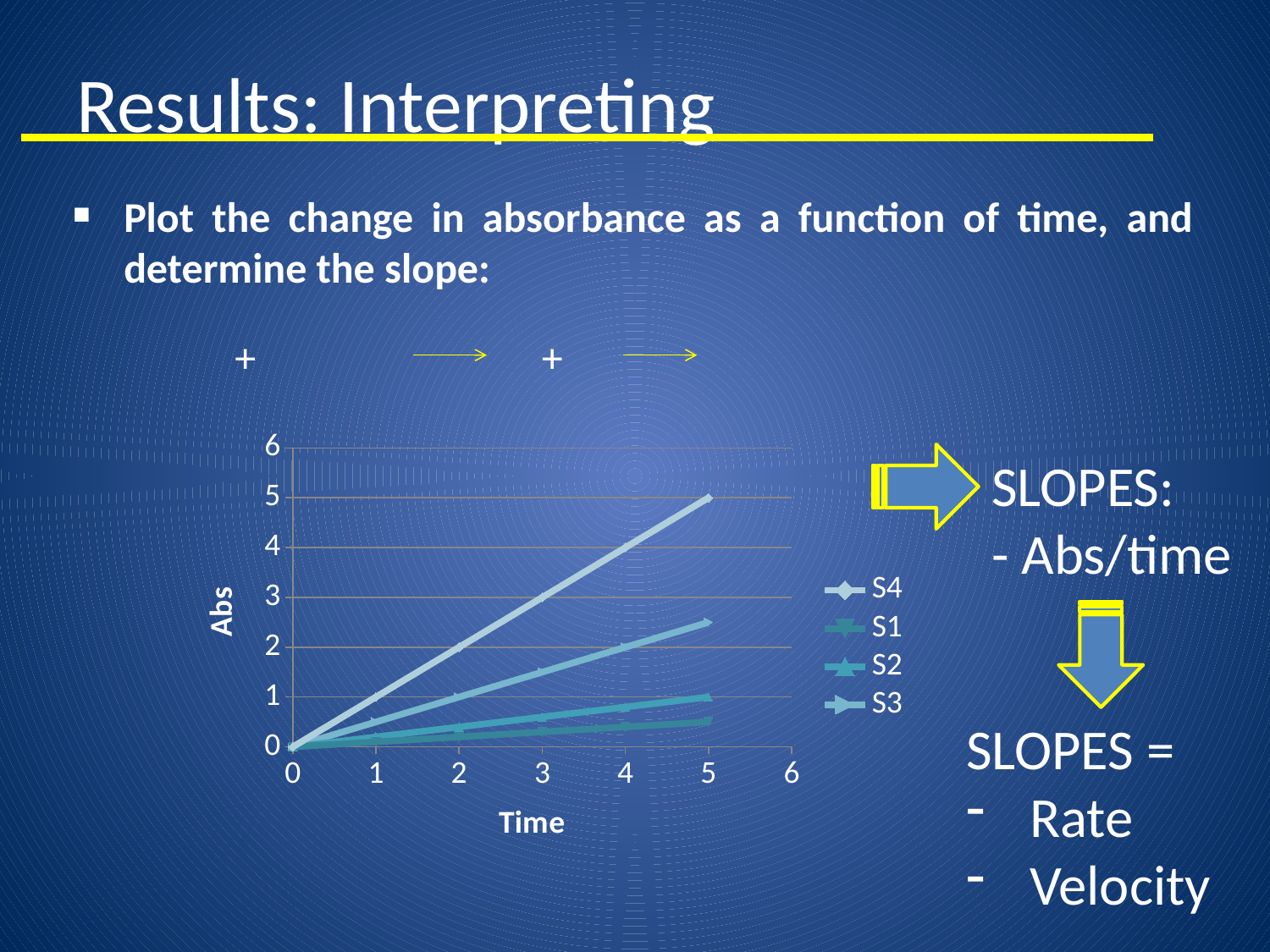
Is the Abs value for S3 at time 5 greater or less than 2? greater What is the label of the vertical axis of the chart? Abs Which series has the lowest absorbance at time 5? S1 Is the Abs value for S1 at time 5 greater or less than 1? less What is the Abs value of S4 at time 5? 5 Which series has the highest absorbance at time 5? S4 What kind of chart is shown on the slide? line chart What is the Abs value of S2 at time 5? 1 How many series does the chart legend list? 4 At time 5, which series has the larger Abs value, S4 or S2? S4 Do the Abs values rise or fall as Time increases? rise What is the difference between the Abs values of S4 and S2 at time 5? 4